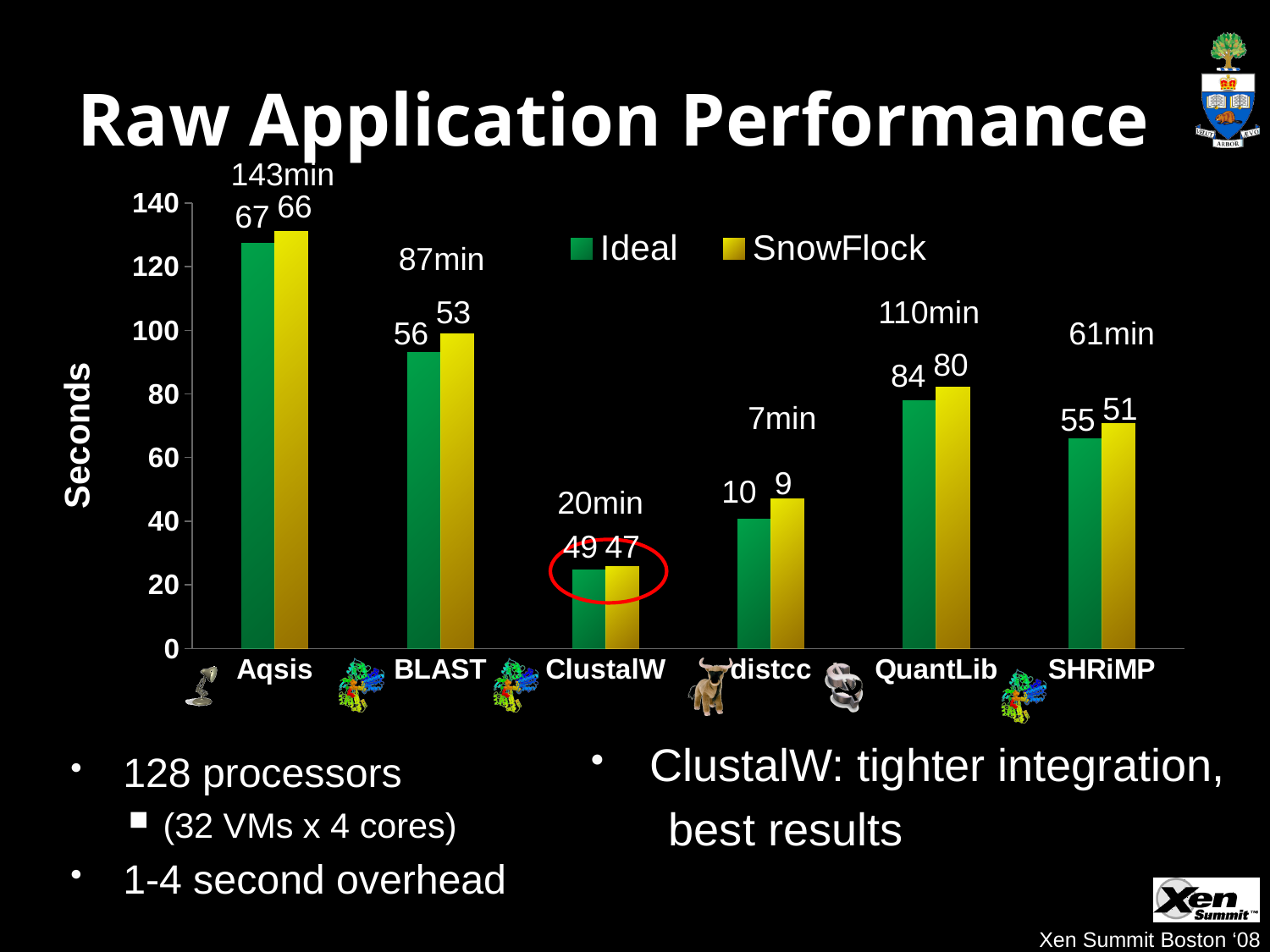
What is the difference between the Ideal and SnowFlock values for QuantLib? 4 How many series does the legend list? 2 How many applications are shown on the x axis? 6 What type of chart is shown on the slide? bar chart What is the Ideal value for BLAST? 56 What is the title of the chart? Raw Application Performance What is the SnowFlock value for ClustalW? 47 What is the Ideal value for distcc? 10 What is the SnowFlock value for QuantLib? 80 What label is shown on the y axis? Seconds